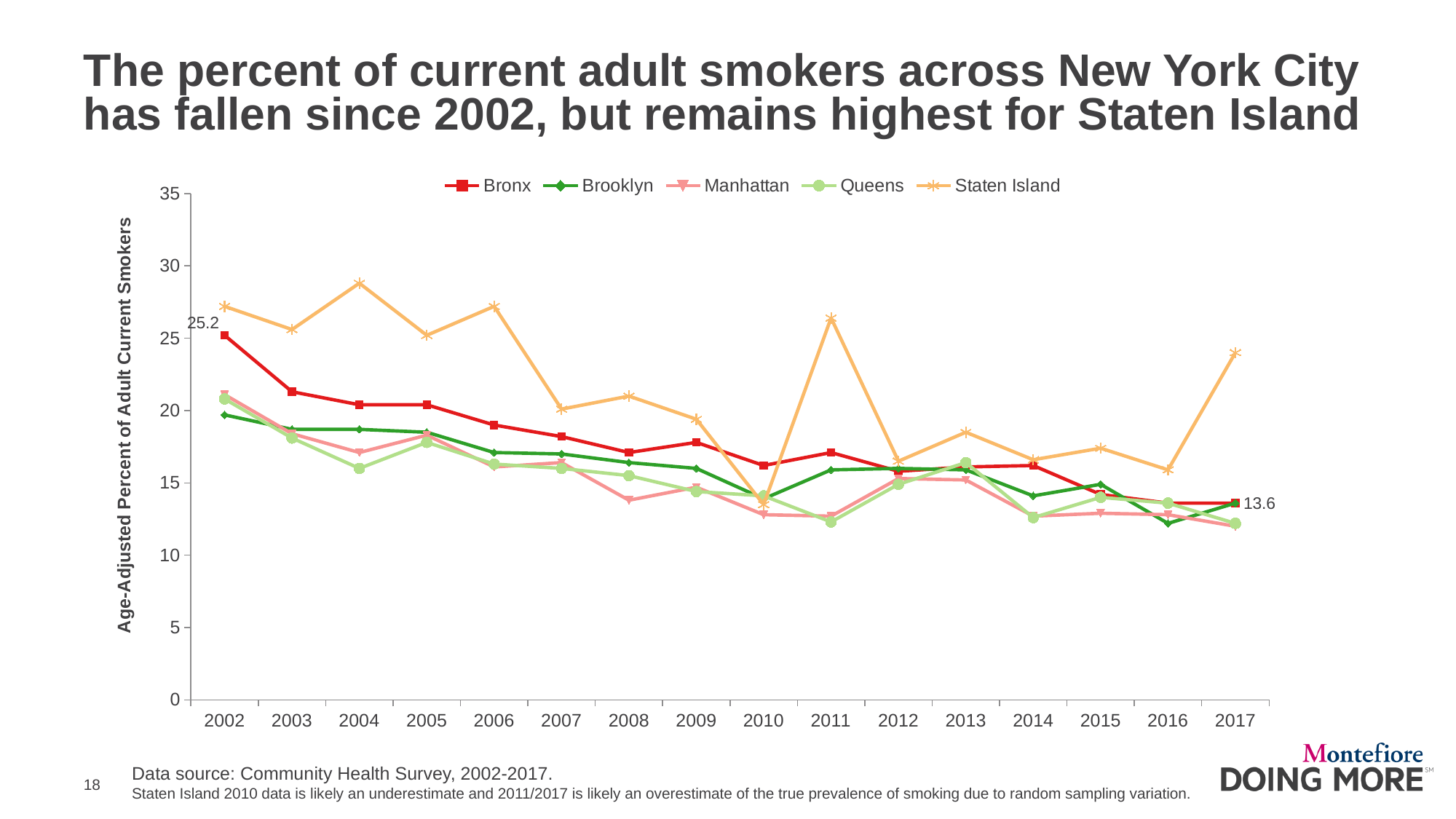
What is the value for the Bronx in 2017? 13.6 In 2002, which is larger: the value for the Bronx or the value for Brooklyn? Bronx Is the value for Queens in 2011 greater or less than 15? less Which borough has the highest value in 2017? Staten Island Does the Bronx line rise or fall from 2002 to 2017? Fall What kind of chart is shown on the slide? Line chart How many years are shown on the x axis? 16 Is the value for Staten Island in 2004 greater or less than 25? greater By how much did the Bronx value fall from 2002 to 2017? 11.6 What is the title of the y axis? Age-Adjusted Percent of Adult Current Smokers How many series does the legend list? 5 What is the value for the Bronx in 2002? 25.2